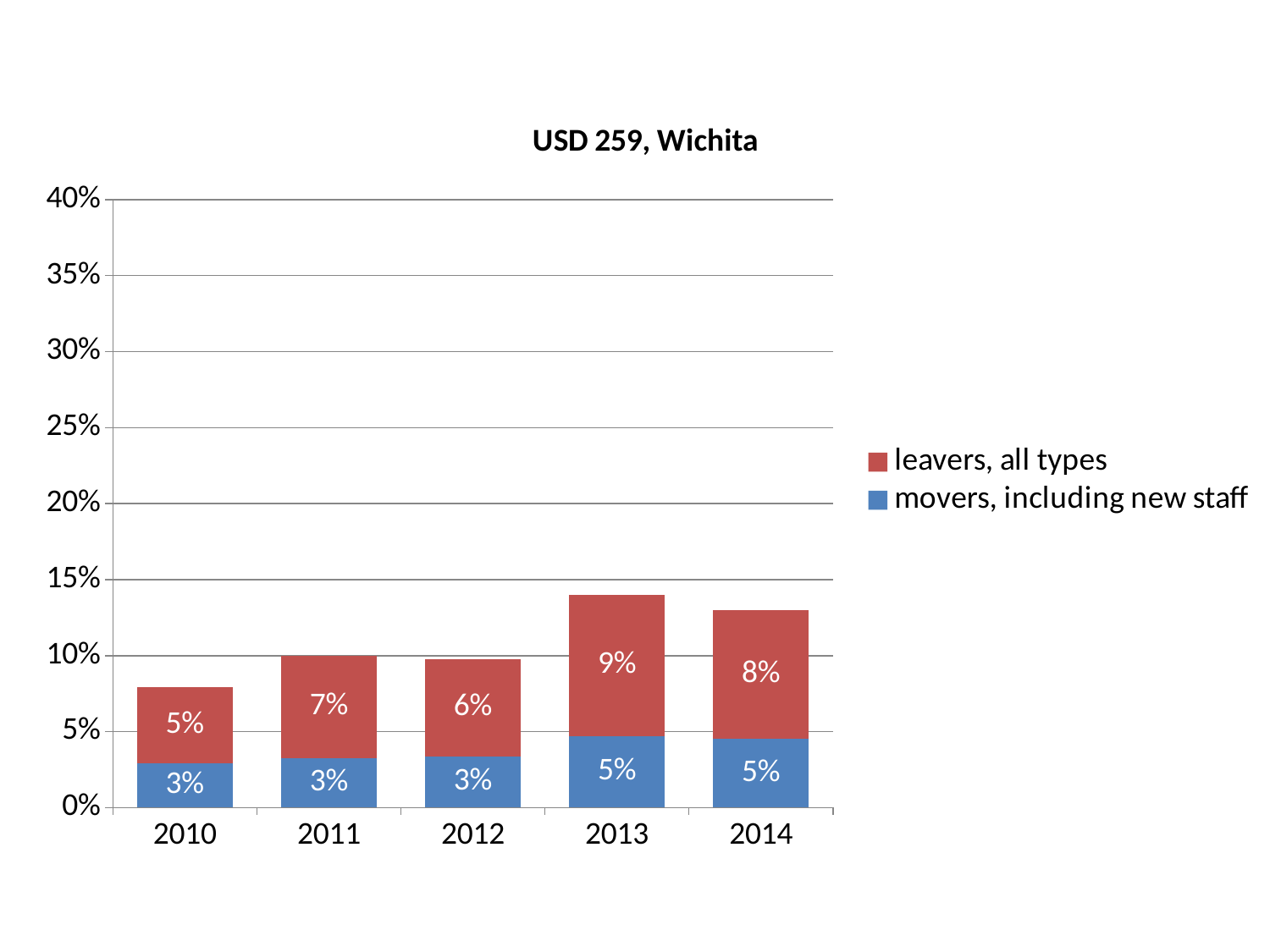
How many series does the legend list? 2 What kind of chart is shown on the slide? Stacked bar chart How many years are shown on the x axis? 5 Is the total height of the stacked bar for 2013 greater or less than 10%? greater In which year is the value for leavers, all types lowest? 2010 In which year is the value for leavers, all types highest? 2013 What is the value for leavers, all types in 2013? 9% What is the value for leavers, all types in 2014? 8% What is the value for movers, including new staff in 2011? 3% What is the difference between the leavers, all types values for 2013 and 2010? 4 percentage points What is the title of the chart? USD 259, Wichita Which is larger, the leavers, all types value for 2011 or for 2012? 2011